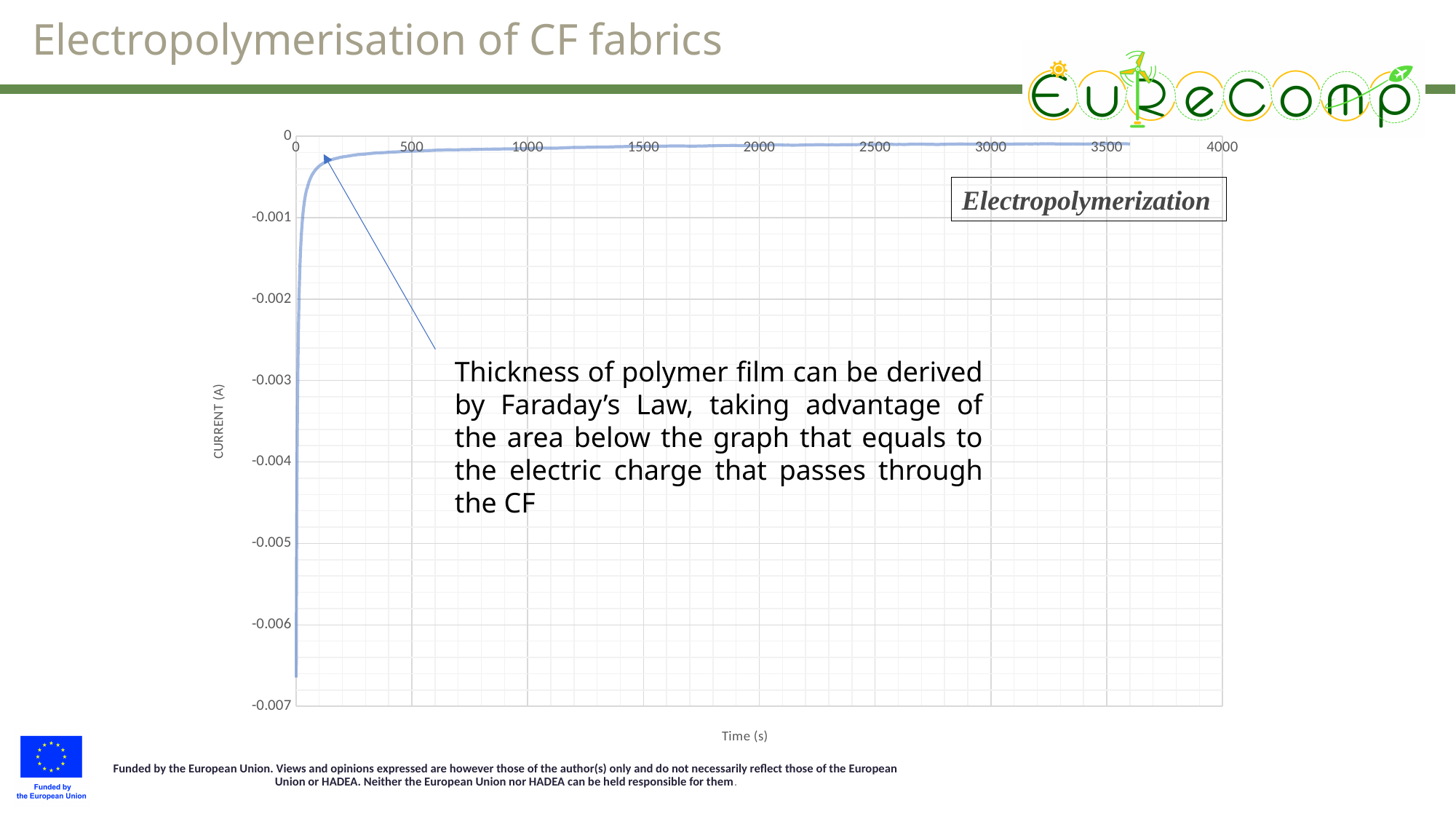
Is the current value at time 0 greater or less than -0.006? less What is the label of the horizontal axis of the chart? Time (s) Is the current value at time 1000 greater or less than -0.002? greater Do the current values rise or fall as time increases along the x axis? rise What is the highest tick value shown on the horizontal axis of the chart? 4000 Is the current value at time 2000 greater or less than -0.001? greater Which is larger, the current at time 0 or the current at time 3000? the current at time 3000 What kind of chart is shown on the slide? line chart What is the lowest value shown on the vertical axis of the chart? -0.007